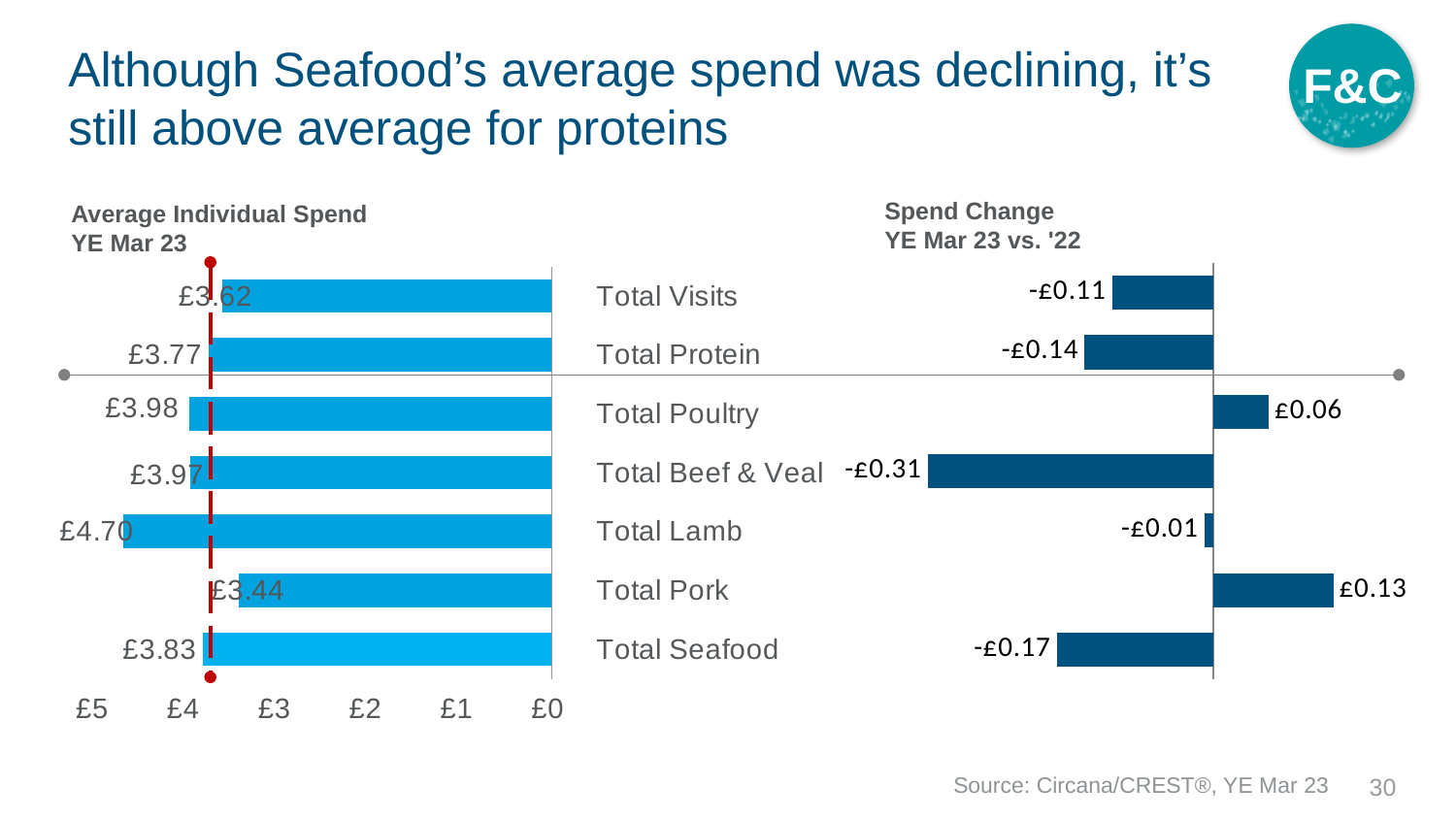
In the Average Individual Spend chart, what is the value for Total Seafood? £3.83 In the Average Individual Spend chart, which category has the lowest value? Total Pork In the Average Individual Spend chart, which category has the highest value? Total Lamb In the Spend Change chart, which category has the lowest value? Total Beef & Veal In the Spend Change chart, what is the value for Total Beef & Veal? -£0.31 In the Average Individual Spend chart, what is the difference between Total Seafood and Total Protein? £0.06 In the Spend Change chart, what is the value for Total Pork? £0.13 In the Spend Change chart, is the value for Total Seafood larger or smaller than the value for Total Visits? smaller What type of chart is the Spend Change chart? bar chart In the Average Individual Spend chart, how many categories are shown? 7 In the Average Individual Spend chart, what is the value for Total Lamb? £4.70 In the Spend Change chart, which category has the largest positive change? Total Pork